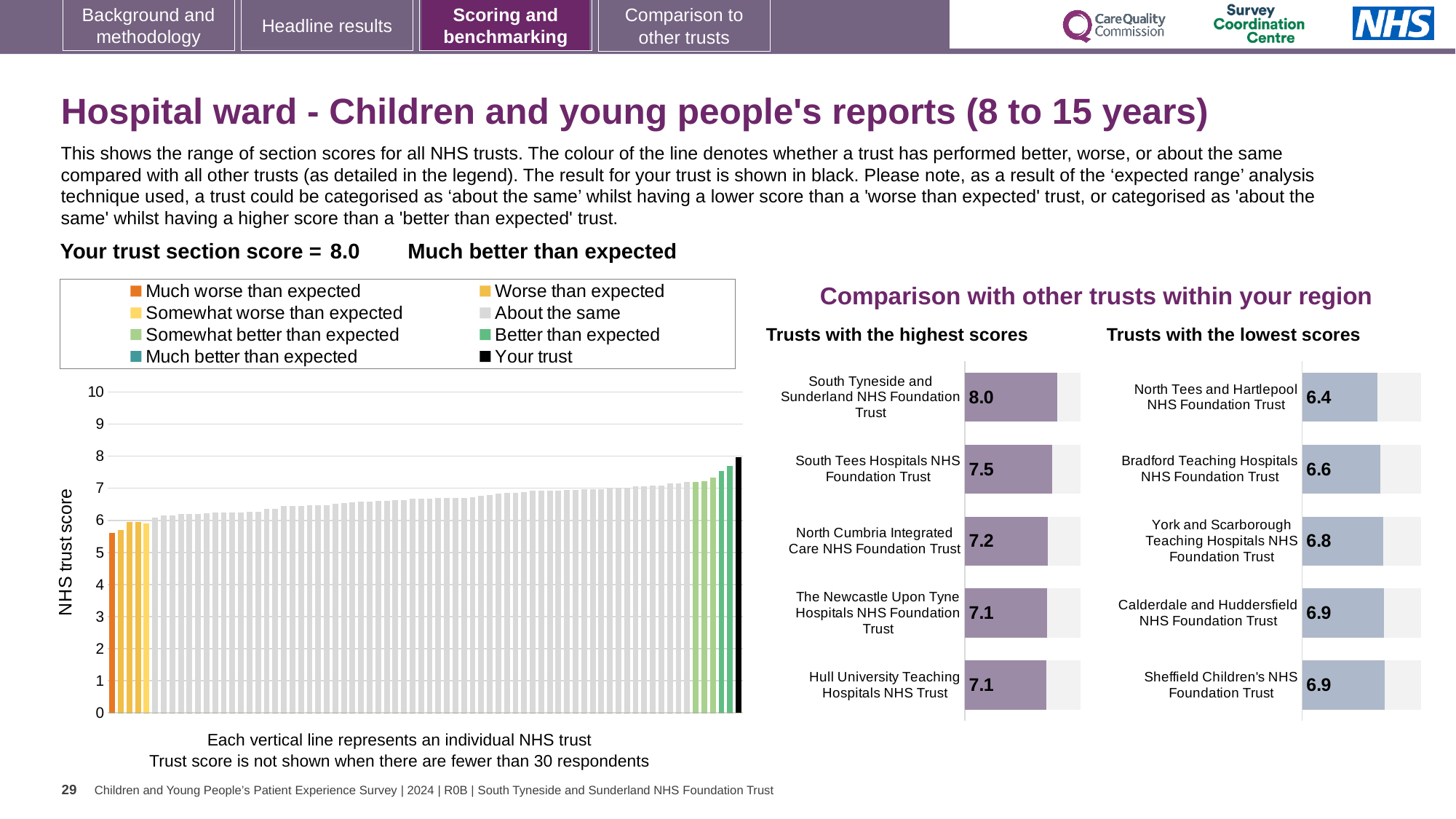
In the 'Trusts with the highest scores' chart, what is the score for South Tees Hospitals NHS Foundation Trust? 7.5 In the 'Trusts with the lowest scores' chart, what is the score for York and Scarborough Teaching Hospitals NHS Foundation Trust? 6.8 In the 'Trusts with the lowest scores' chart, which trust has the lowest score? North Tees and Hartlepool NHS Foundation Trust In the 'Trusts with the highest scores' chart, which trust has the highest score? South Tyneside and Sunderland NHS Foundation Trust In the 'Trusts with the lowest scores' chart, what is the difference between the scores of Sheffield Children's NHS Foundation Trust and North Tees and Hartlepool NHS Foundation Trust? 0.5 In the 'Trusts with the lowest scores' chart, which has the higher score: Bradford Teaching Hospitals NHS Foundation Trust or Calderdale and Huddersfield NHS Foundation Trust? Calderdale and Huddersfield NHS Foundation Trust How many entries does the legend of the NHS trust score chart on the left list? 8 What kind of chart is the NHS trust score chart on the left of the slide? Bar chart In the NHS trust score chart on the left, do the values rise or fall from left to right? Rise In the 'Trusts with the highest scores' chart, what is the difference between the scores of South Tyneside and Sunderland NHS Foundation Trust and Hull University Teaching Hospitals NHS Trust? 0.9 In the NHS trust score chart on the left, is the value of the leftmost (orange) bar greater or less than 6? less How many trusts are shown in the 'Trusts with the highest scores' chart? 5